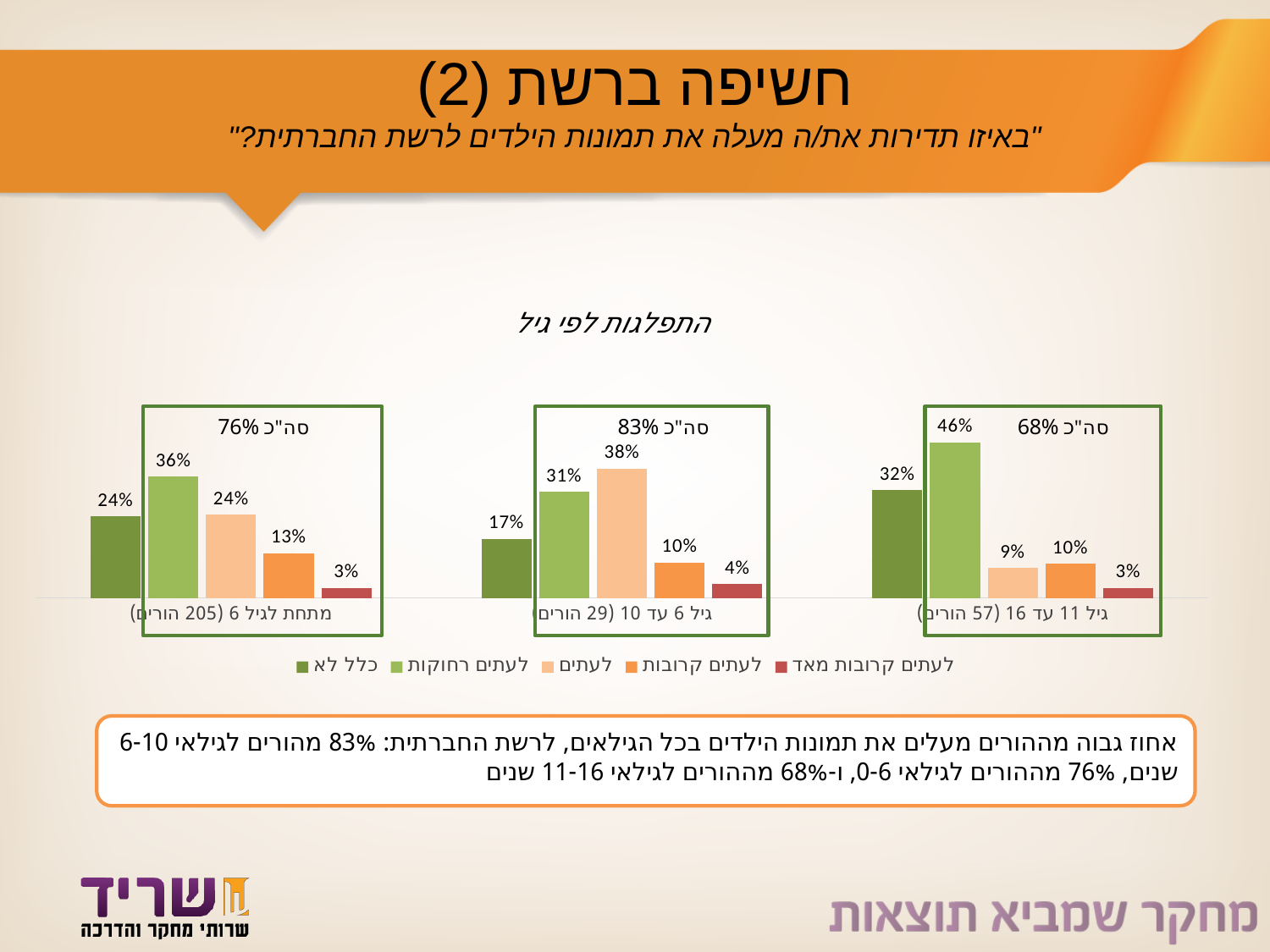
Which age group has the highest "סה"כ" (total) value shown? גיל 6 עד 10 Which age group has the lowest "סה"כ" (total) value shown? גיל 11 עד 16 What kind of chart is shown on the slide? bar chart What is the "סה"כ" value shown for the "מתחת לגיל 6" group? 76% What is the value for "לעתים קרובות מאד" in the "גיל 6 עד 10" group? 4% How many series does the legend list? 5 Which is larger: "לעתים רחוקות" in the "מתחת לגיל 6" group or "לעתים רחוקות" in the "גיל 11 עד 16" group? גיל 11 עד 16 What is the value for "לעתים" in the "גיל 6 עד 10" group? 38% How many age groups (categories) are shown on the x axis? 3 What is the difference between the "סה"כ" value for "גיל 6 עד 10" and for "גיל 11 עד 16"? 15% What is the value for "כלל לא" in the "מתחת לגיל 6" group? 24% What is the value for "לעתים רחוקות" in the "גיל 11 עד 16" group? 46%